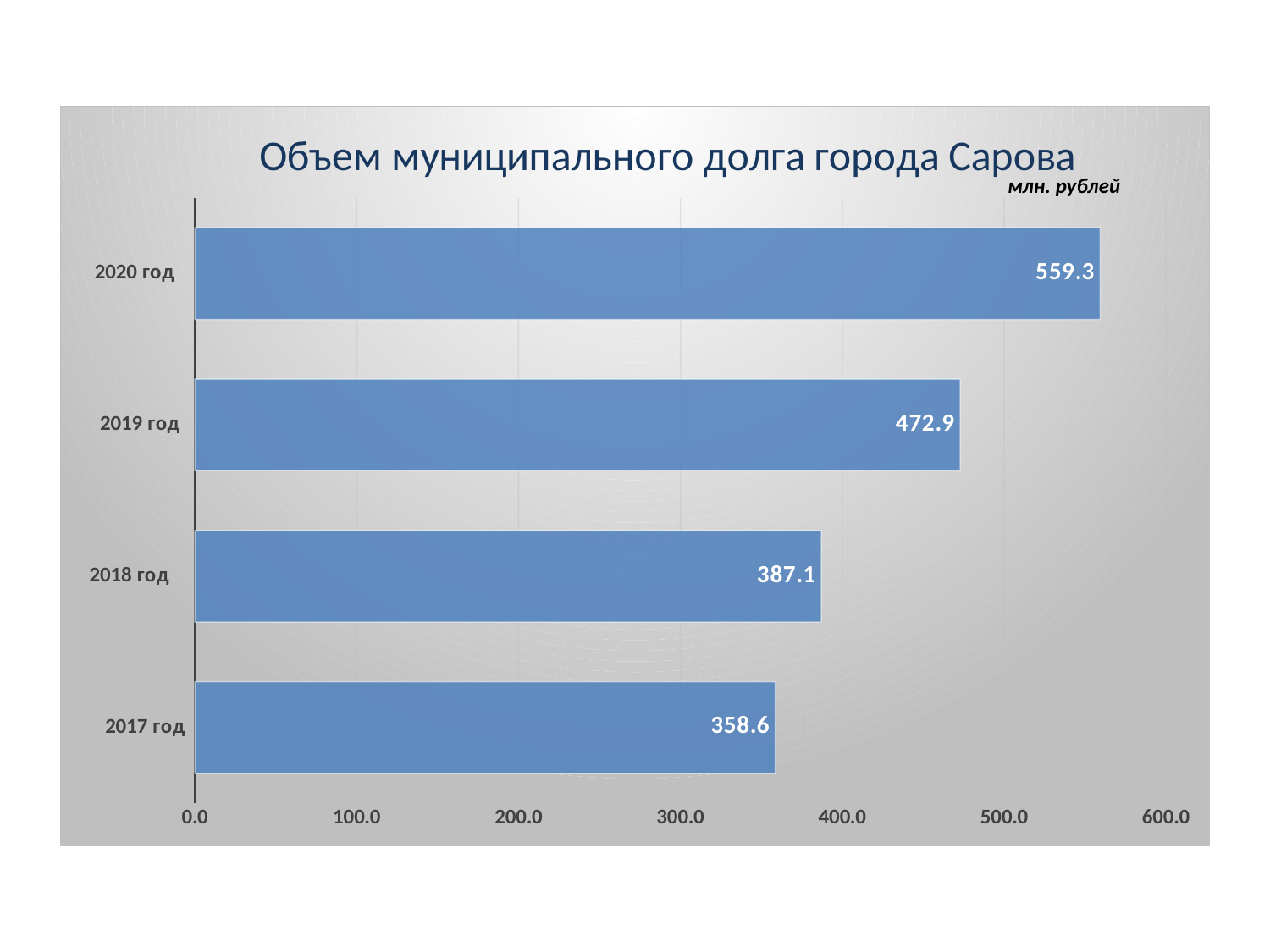
What is the title of the chart? Объем муниципального долга города Сарова How many years are shown in the chart? 4 What is the value for 2020 год? 559.3 What is the value for 2017 год? 358.6 Is the value for 2019 год greater or less than 400.0? greater Which year has the lowest municipal debt? 2017 год What kind of chart is shown on the slide? bar chart What is the difference between the values for 2020 год and 2019 год? 86.4 Which year has the highest municipal debt? 2020 год Which is larger, the value for 2019 год or the value for 2018 год? 2019 год What is the value for 2018 год? 387.1 What is the difference between the values for 2018 год and 2017 год? 28.5